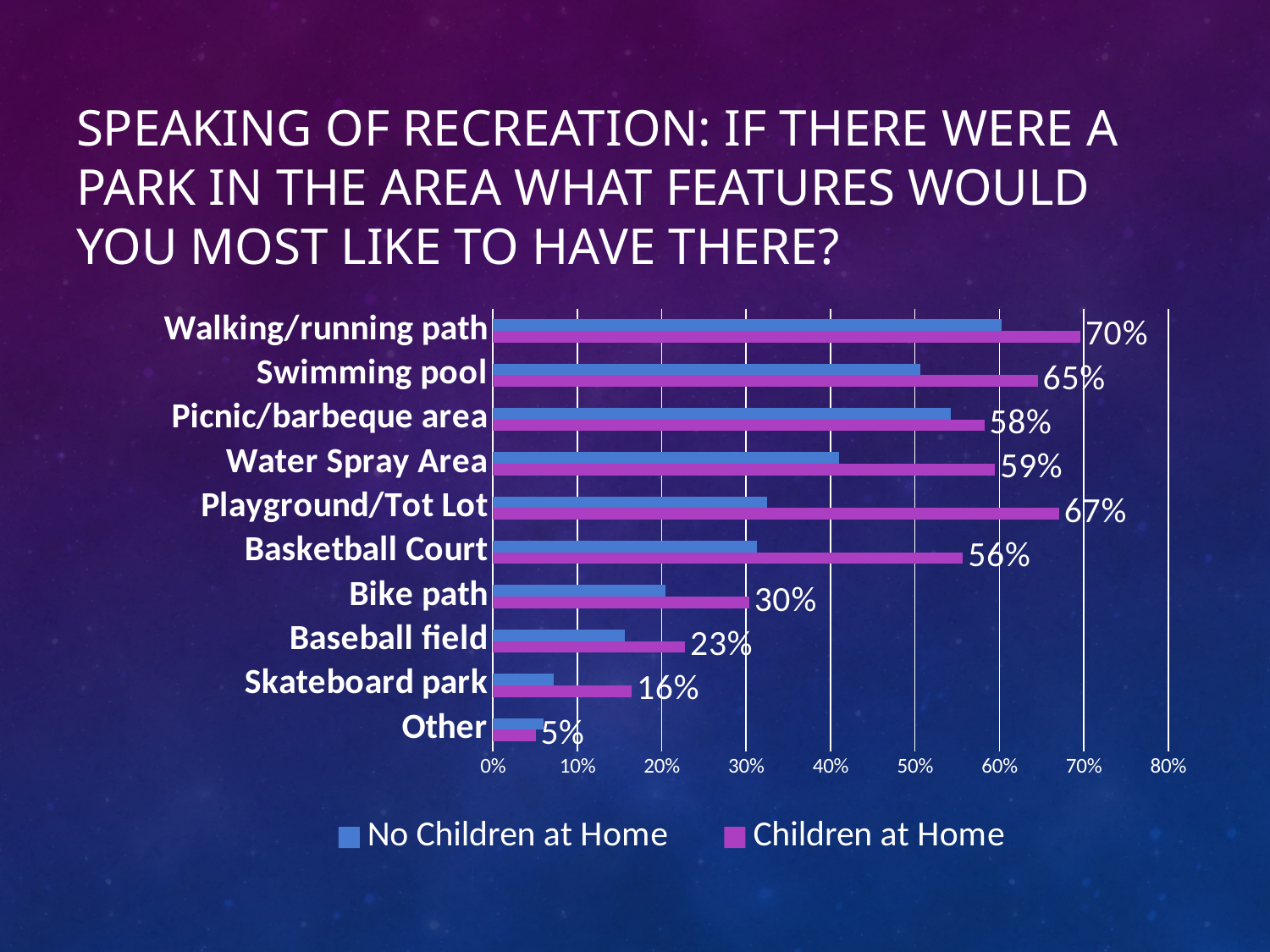
What percentage of respondents with Children at Home chose Walking/running path? 70% Which feature has the highest Children at Home value? Walking/running path What is the difference between the Children at Home values for Walking/running path and Bike path? 40 percentage points What is the Children at Home value for Skateboard park? 16% Is the No Children at Home value for Walking/running path greater or less than 50%? greater What type of chart is shown on the slide? Bar chart How many park features are listed on the chart? 10 For Children at Home, which is larger: Playground/Tot Lot or Basketball Court? Playground/Tot Lot Which category has the lowest Children at Home value? Other Is the No Children at Home value for Playground/Tot Lot greater or less than 40%? less What is the Children at Home value for Playground/Tot Lot? 67% How many series does the legend list? 2